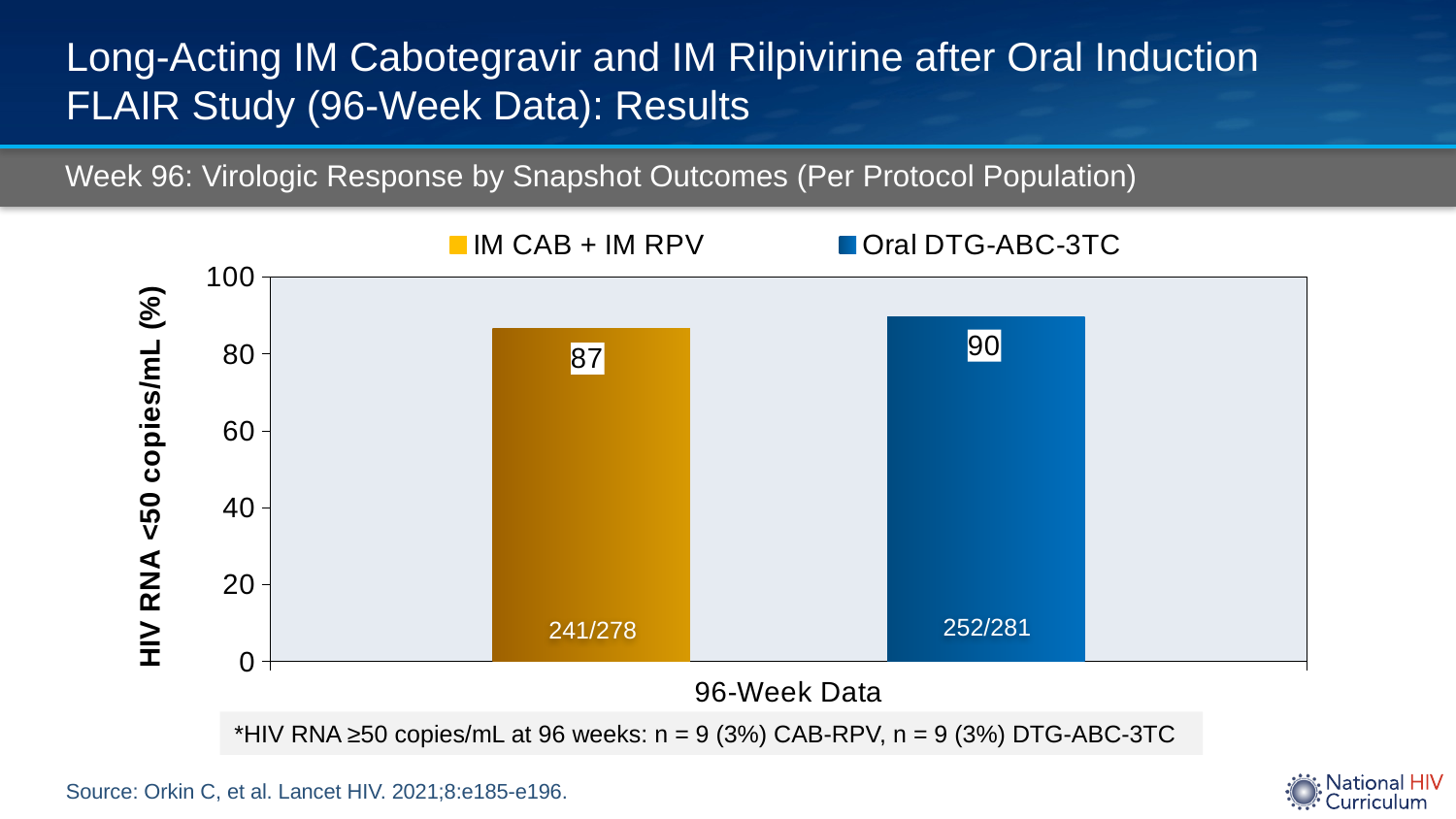
Is the value for IM CAB + IM RPV greater or less than 80? greater What is the value for Oral DTG-ABC-3TC? 90 Which series has the higher value? Oral DTG-ABC-3TC What is the label on the y axis? HIV RNA <50 copies/mL (%) How many series does the legend list? 2 What is the value for IM CAB + IM RPV? 87 Which series has the lower value? IM CAB + IM RPV What is the label on the x axis? 96-Week Data What kind of chart is shown? bar chart What is the difference between the Oral DTG-ABC-3TC value and the IM CAB + IM RPV value? 3 What fraction is printed on the Oral DTG-ABC-3TC bar? 252/281 What fraction is printed on the IM CAB + IM RPV bar? 241/278